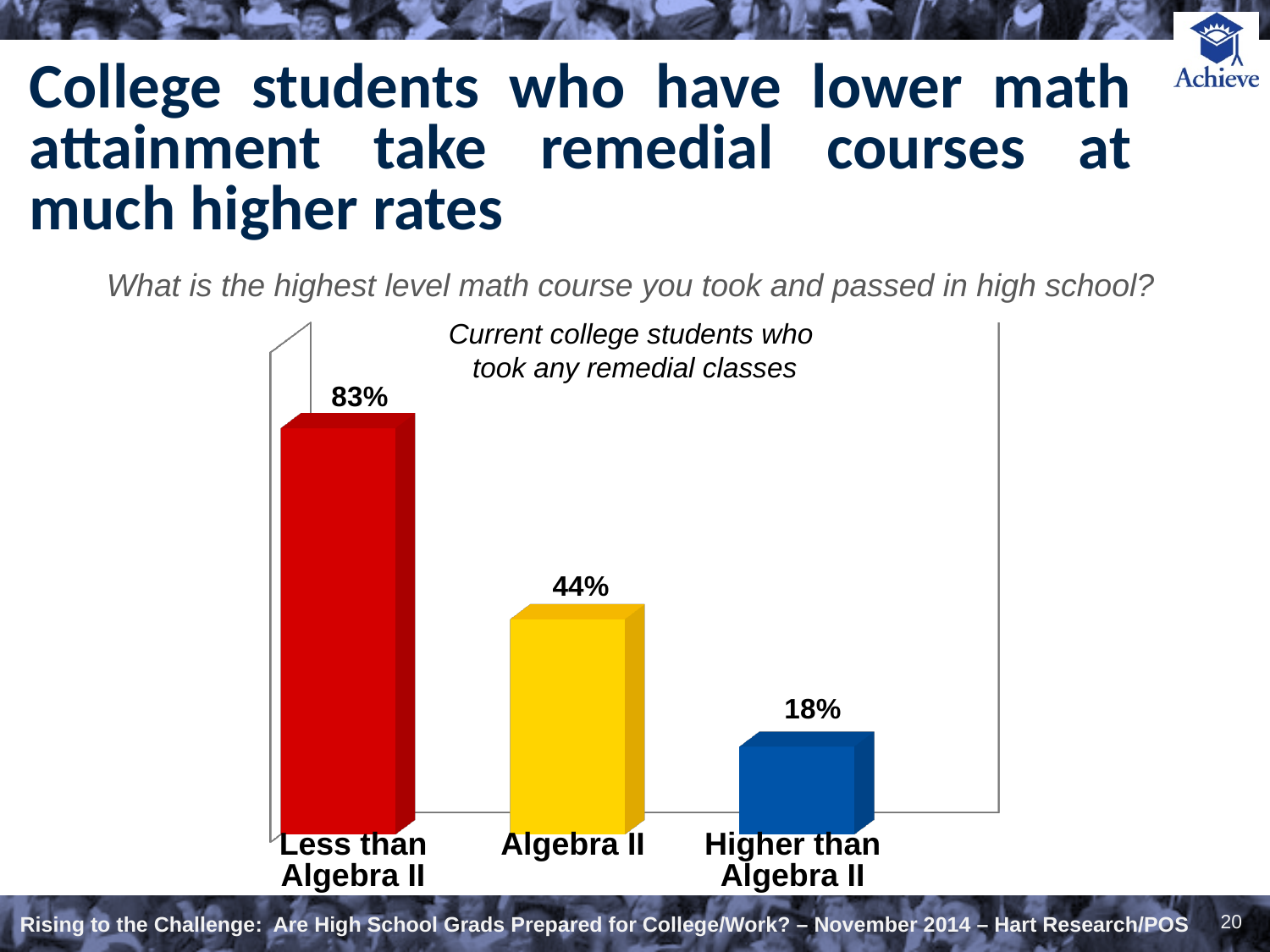
What percentage of current college students whose highest math course was Less than Algebra II took any remedial classes? 83% Which category has the highest percentage of students who took remedial classes? Less than Algebra II What kind of chart is shown on the slide? Bar chart What is the difference in percentage points between Less than Algebra II and Algebra II? 39 What is the value shown for Algebra II? 44% Do the values rise or fall moving from left to right across the categories? Fall What is the value shown for Higher than Algebra II? 18% How many categories are shown in the chart? 3 Which is larger, the value for Algebra II or the value for Higher than Algebra II? Algebra II Which category has the lowest percentage of students who took remedial classes? Higher than Algebra II What colour is the bar for Algebra II? Yellow What is the difference in percentage points between Algebra II and Higher than Algebra II? 26